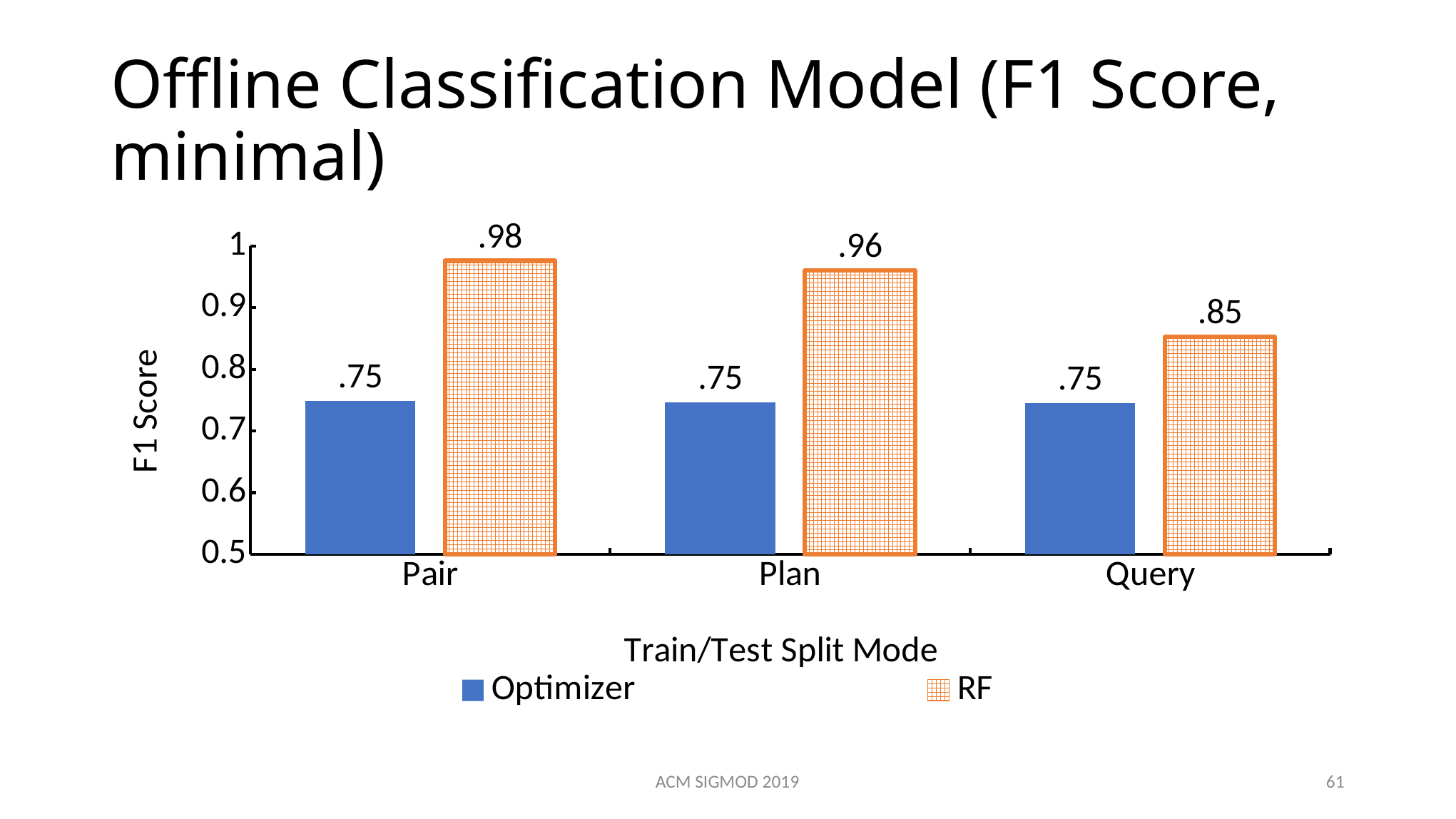
In the Query split mode, which series has the higher F1 score, Optimizer or RF? RF What is the label of the x axis? Train/Test Split Mode What is the F1 score for RF in the Pair split mode? .98 What is the F1 score for RF in the Query split mode? .85 How many series does the legend list? 2 Is the RF F1 score for Query greater or less than 0.9? less Which split mode has the highest RF F1 score? Pair How many split modes are shown on the x axis? 3 What kind of chart is shown on the slide? bar chart What is the F1 score for Optimizer in the Plan split mode? .75 What is the difference between the RF and Optimizer F1 scores in the Plan split mode? .21 Which split mode has the lowest RF F1 score? Query